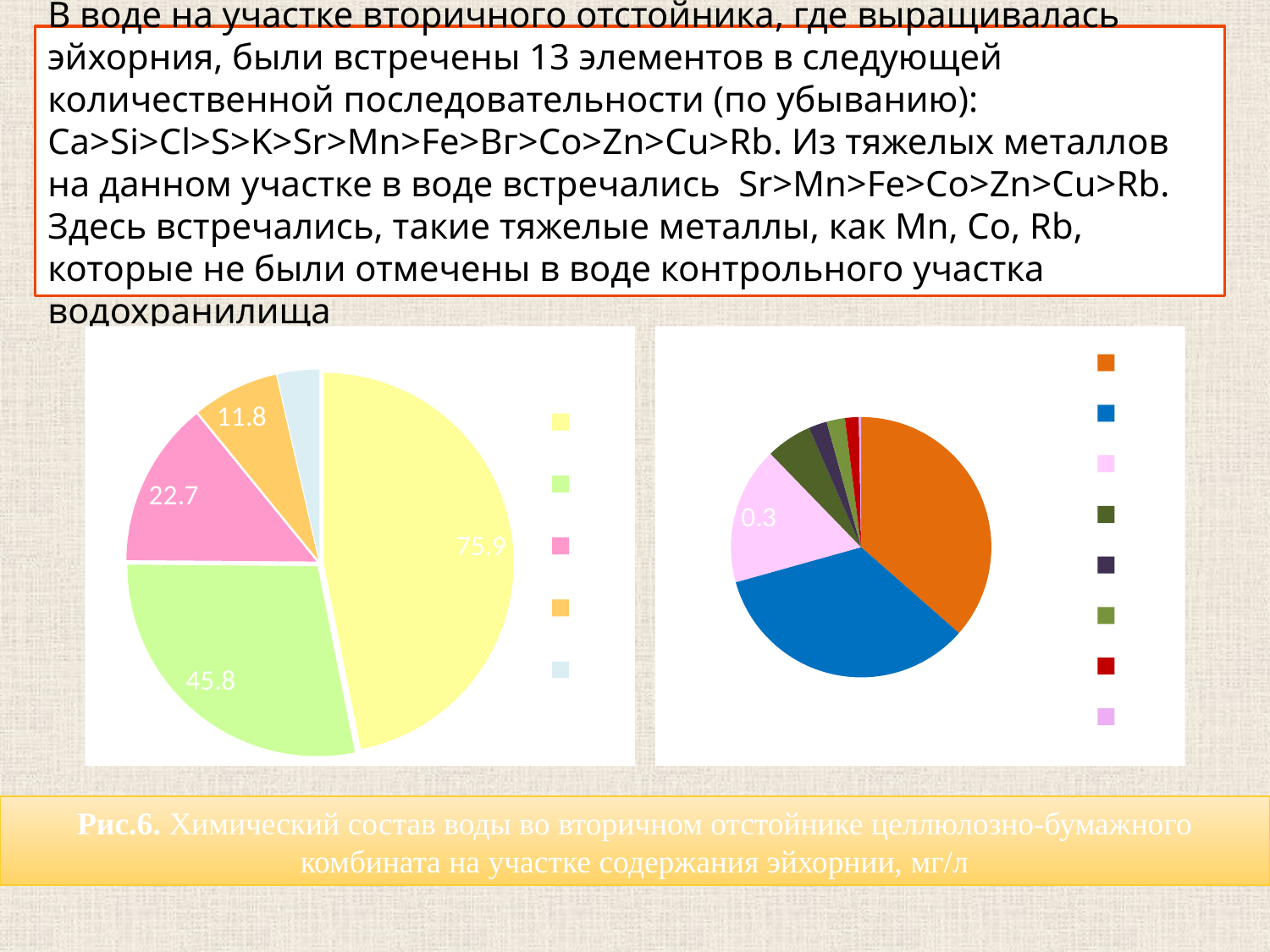
In the left pie chart, what value is shown on the yellow slice? 75.9 In the left pie chart, which colour slice is the largest? yellow In the right pie chart, which colour slice is the largest? orange What kind of chart is the right chart on the slide? pie chart In the left pie chart, what is the difference between the yellow slice (75.9) and the green slice (45.8)? 30.1 In the left pie chart, which is larger, the green slice or the pink slice? green slice In the left pie chart, what value is shown on the green slice? 45.8 In the left pie chart, what value is shown on the pink slice? 22.7 How many entries does the legend of the right pie chart list? 8 In the left pie chart, what value is shown on the orange slice? 11.8 What kind of chart is the left chart on the slide? pie chart In the left pie chart, what is the difference between the pink slice (22.7) and the orange slice (11.8)? 10.9